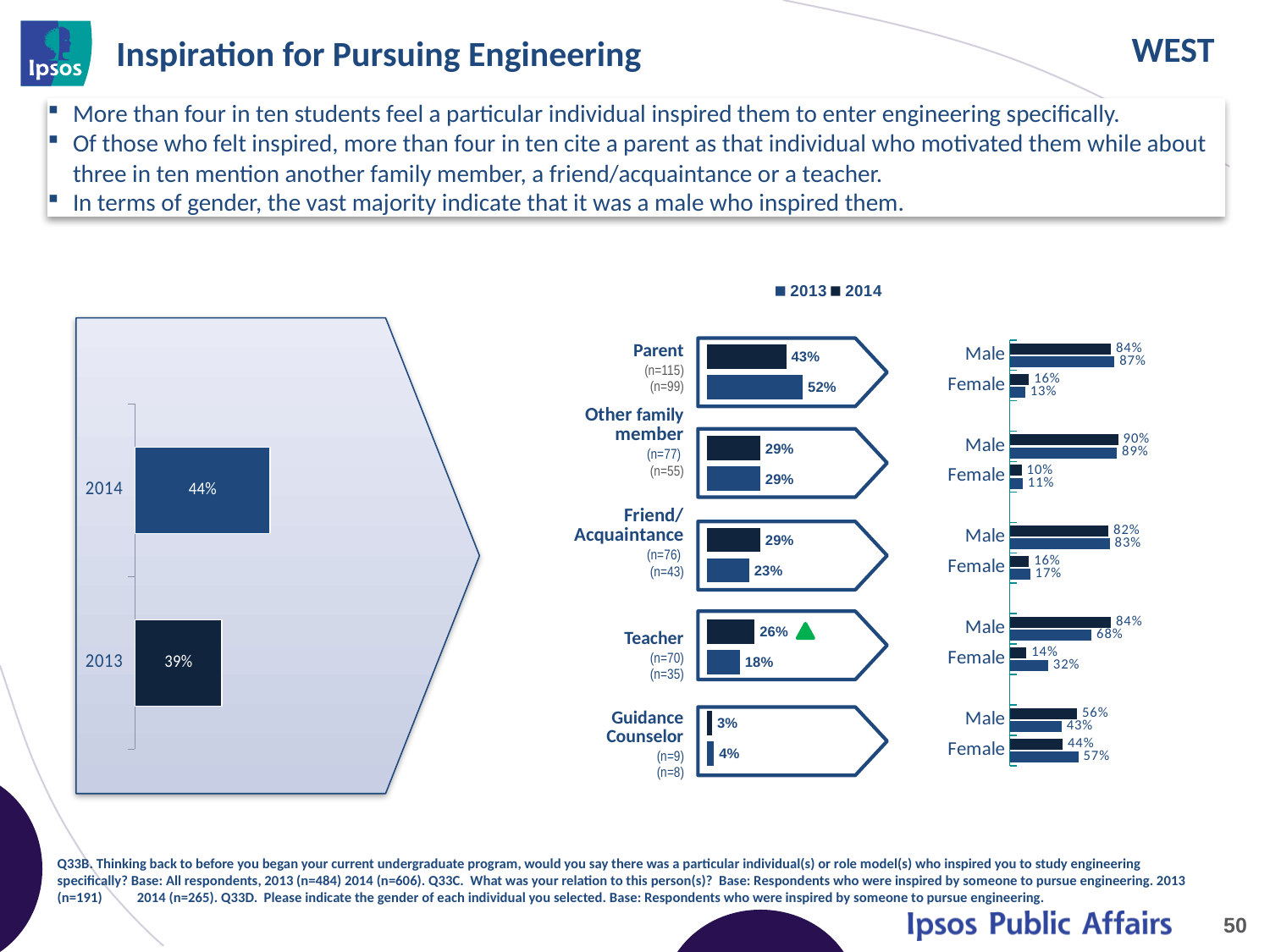
In the middle chart, how many relationship categories are shown? 5 What kind of chart is the left chart? Bar chart In the middle chart, which category has the lowest values? Guidance Counselor How many series does the legend list? 2 In the middle chart, what is the 2014 value for Parent? 43% In the middle chart, which category has the highest 2014 value? Parent In the right chart, what is the 2013 value for Male under Other family member? 89% In the left chart, what is the value for 2014? 44% In the middle chart, what is the 2013 value for Teacher? 18% In the right chart, what is the 2014 value for Female under Teacher? 14% In the left chart, what is the difference between the 2014 and 2013 values? 5 percentage points In the left chart, what is the value for 2013? 39%